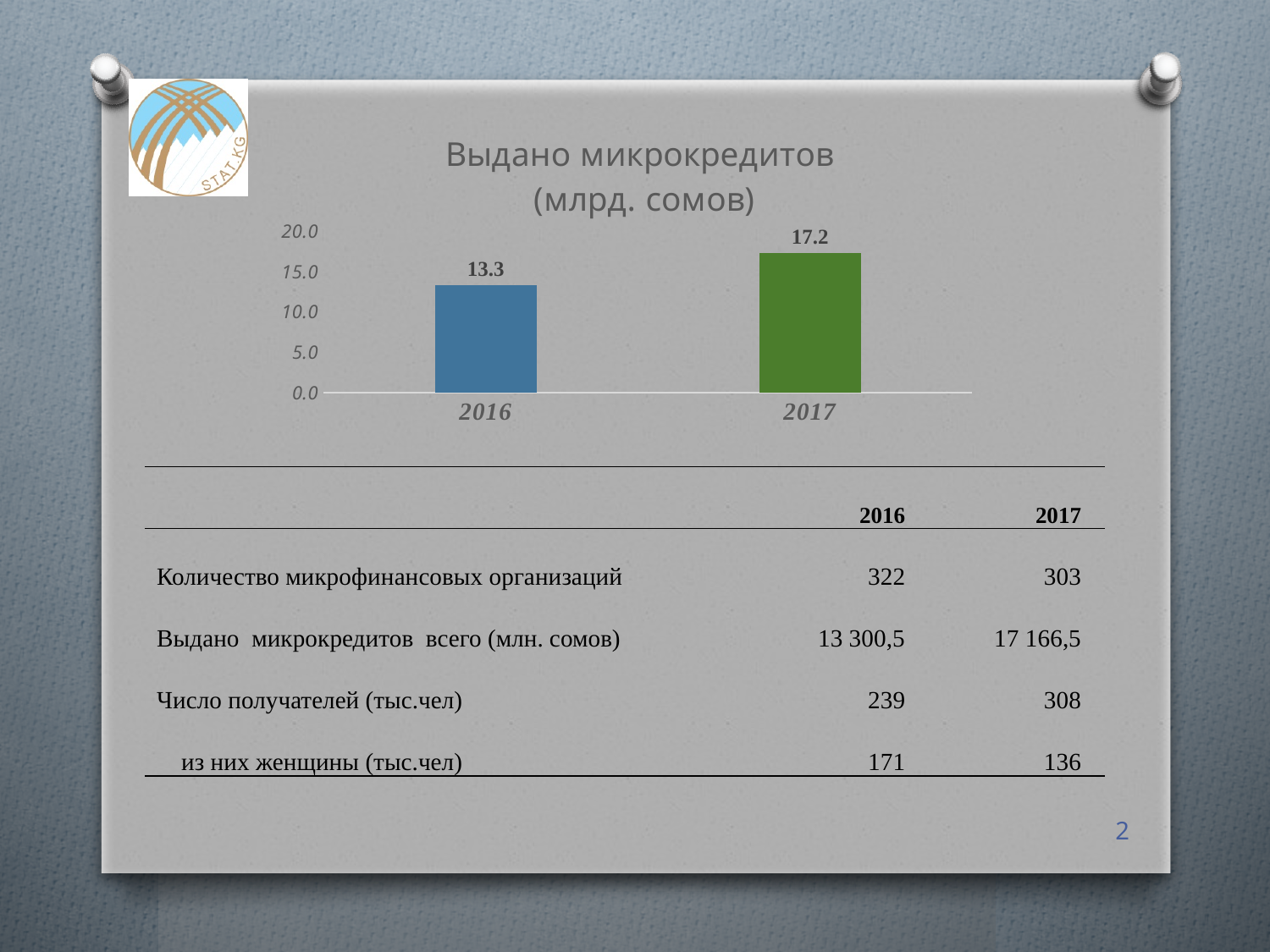
How many bars are shown in the chart? 2 Do the values rise or fall from 2016 to 2017? rise What is the value for 2016 in the chart? 13.3 What is the title of the chart? Выдано микрокредитов (млрд. сомов) Which year has the lower value in the chart? 2016 Is the value for 2016 greater or less than 15.0? less What type of chart is shown on the slide? bar chart Is the value for 2016 larger or smaller than the value for 2017? smaller Is the value for 2017 greater or less than 15.0? greater What is the value for 2017 in the chart? 17.2 Which year has the higher value in the chart? 2017 What is the difference between the 2017 and 2016 values in the chart? 3.9